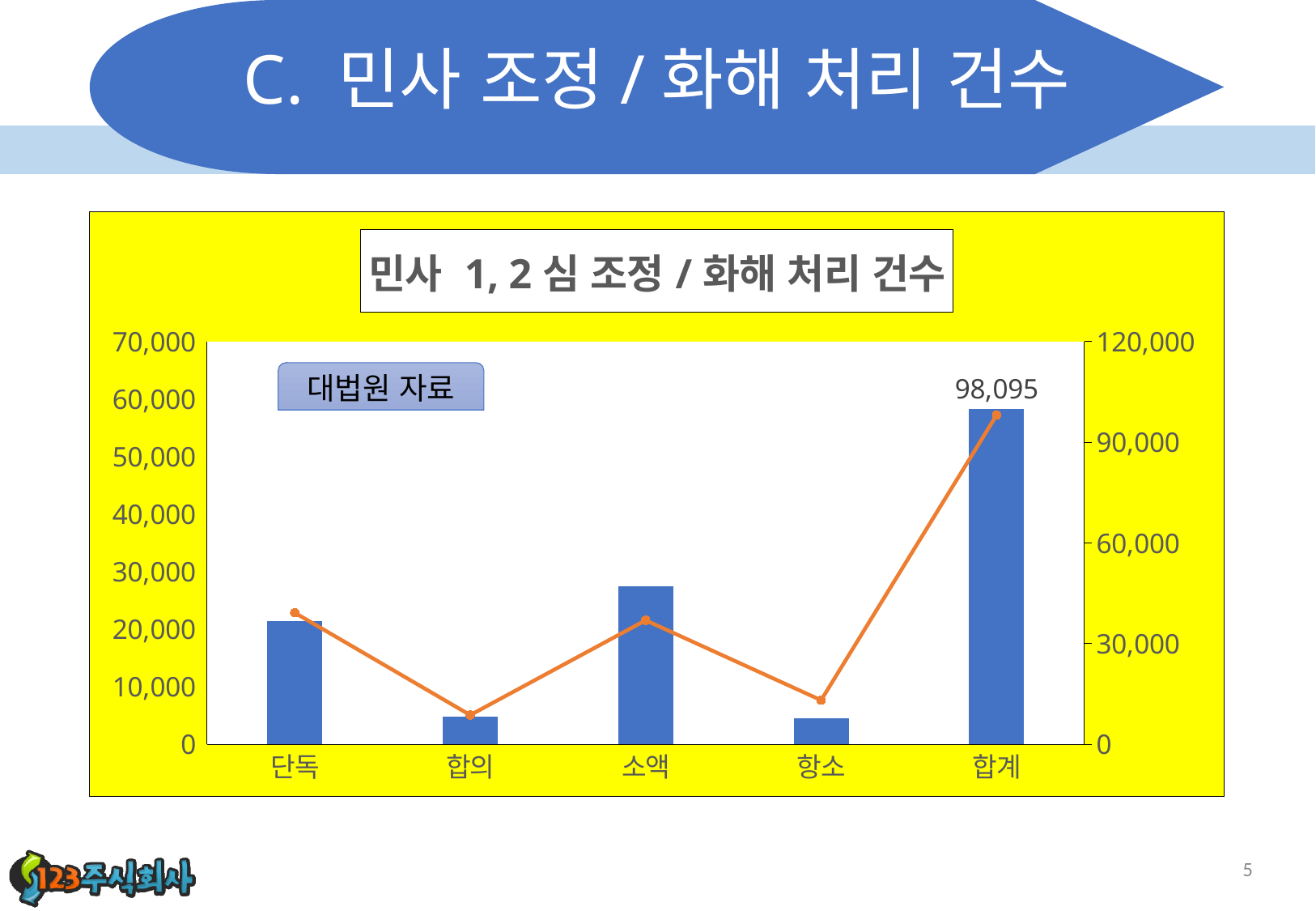
What kind of chart is this? A combination bar and line chart Which has the taller bar, 단독 or 소액? 소액 How many categories are shown on the x axis? 5 Is the bar value for 소액 greater or less than 20,000 on the left axis? greater What is the title of the chart? 민사 1, 2 심 조정 / 화해 처리 건수 Is the bar value for 합계 greater or less than 50,000 on the left axis? greater Is the bar value for 합의 greater or less than 10,000 on the left axis? less What is the value of the line data label shown at 합계? 98,095 Which has the higher point on the orange line, 단독 or 항소? 단독 Which category has the lowest point on the orange line? 합의 Does the orange line rise or fall from 항소 to 합계? rises Which category has the tallest bar? 합계